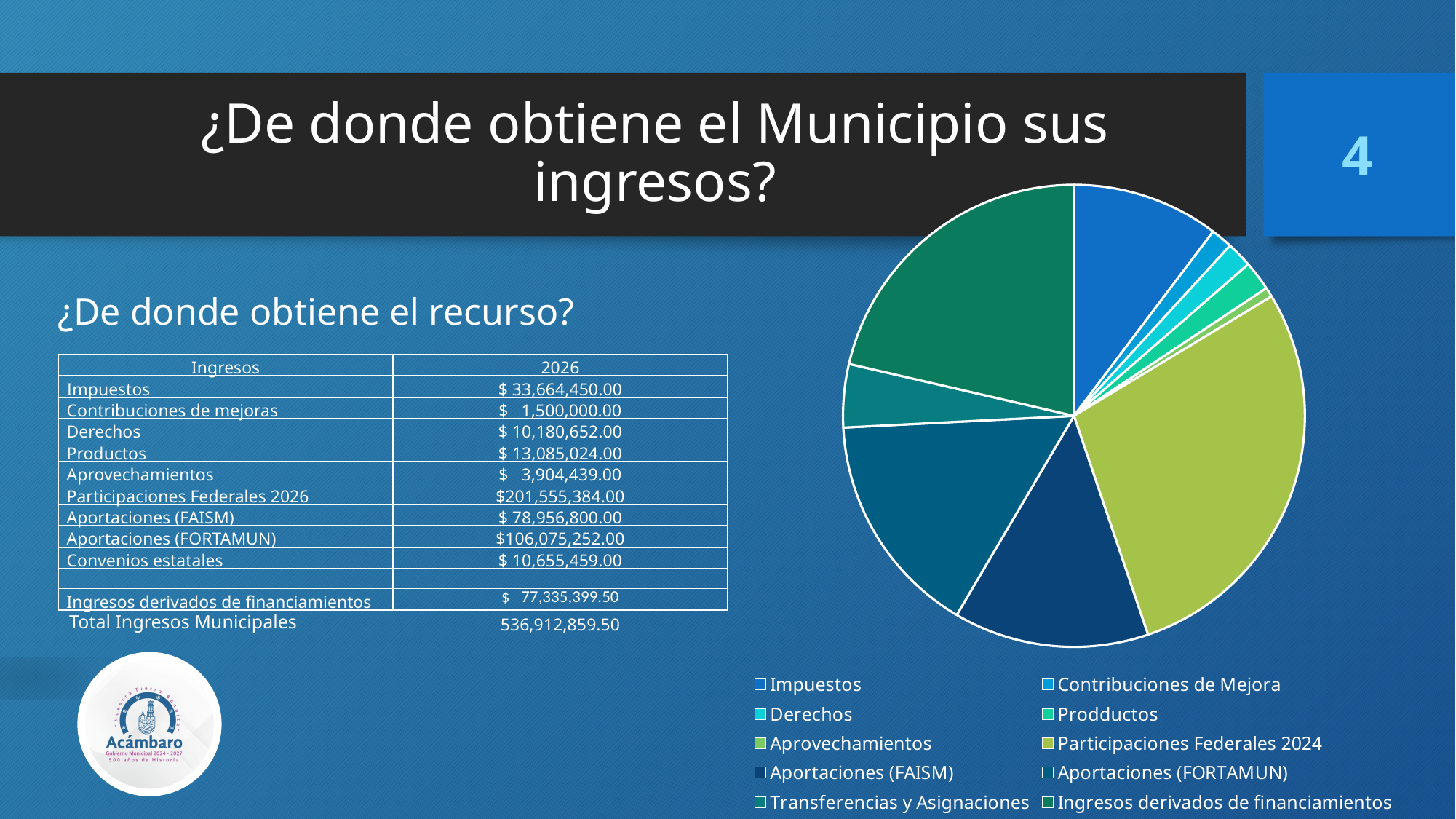
According to the table on the slide, what is the 2026 value for Impuestos? $ 33,664,450.00 What colour is the largest slice of the pie chart? yellow-green In the pie chart, which slice is larger: Aportaciones (FORTAMUN) or Aportaciones (FAISM)? Aportaciones (FORTAMUN) What kind of chart is shown on the slide? pie chart How many entries does the legend of the pie chart list? 10 In the pie chart, which slice is larger: Participaciones Federales 2024 or Impuestos? Participaciones Federales 2024 What is the title of the slide containing the pie chart? ¿De donde obtiene el Municipio sus ingresos? Which category has the largest slice in the pie chart? Participaciones Federales 2024 According to the table on the slide, what is the Total Ingresos Municipales? 536,912,859.50 In the pie chart, which slice is larger: Aportaciones (FAISM) or Derechos? Aportaciones (FAISM) According to the table on the slide, what is the 2026 value for Aportaciones (FORTAMUN)? $106,075,252.00 According to the table on the slide, what is the 2026 value for Participaciones Federales 2026? $201,555,384.00